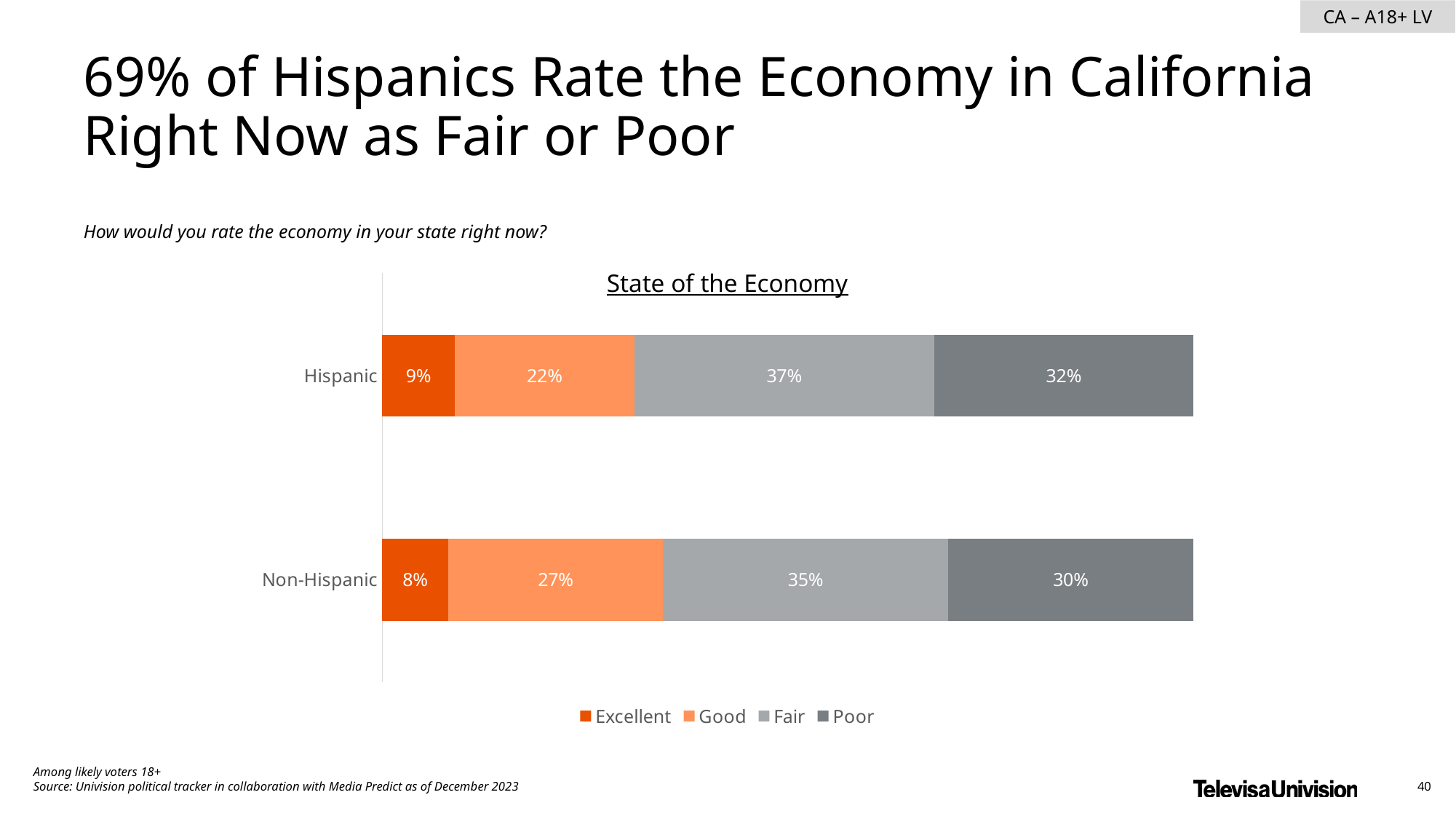
Which rating category has the highest share among Hispanic respondents? Fair How many series does the legend list? 4 What percentage of Hispanic respondents rate the economy as Fair? 37% What is the combined Fair and Poor percentage for Non-Hispanic respondents? 65% What is the difference between the Good percentages for Non-Hispanic and Hispanic respondents? 5 percentage points Which rating category has the lowest share among Non-Hispanic respondents? Excellent What type of chart is shown on the slide? Stacked bar chart Which group has a larger share rating the economy as Poor, Hispanic or Non-Hispanic? Hispanic What percentage of Non-Hispanic respondents rate the economy as Good? 27% What percentage of Non-Hispanic respondents rate the economy as Excellent? 8% How many groups are shown on the chart? 2 What percentage of Hispanic respondents rate the economy as Poor? 32%